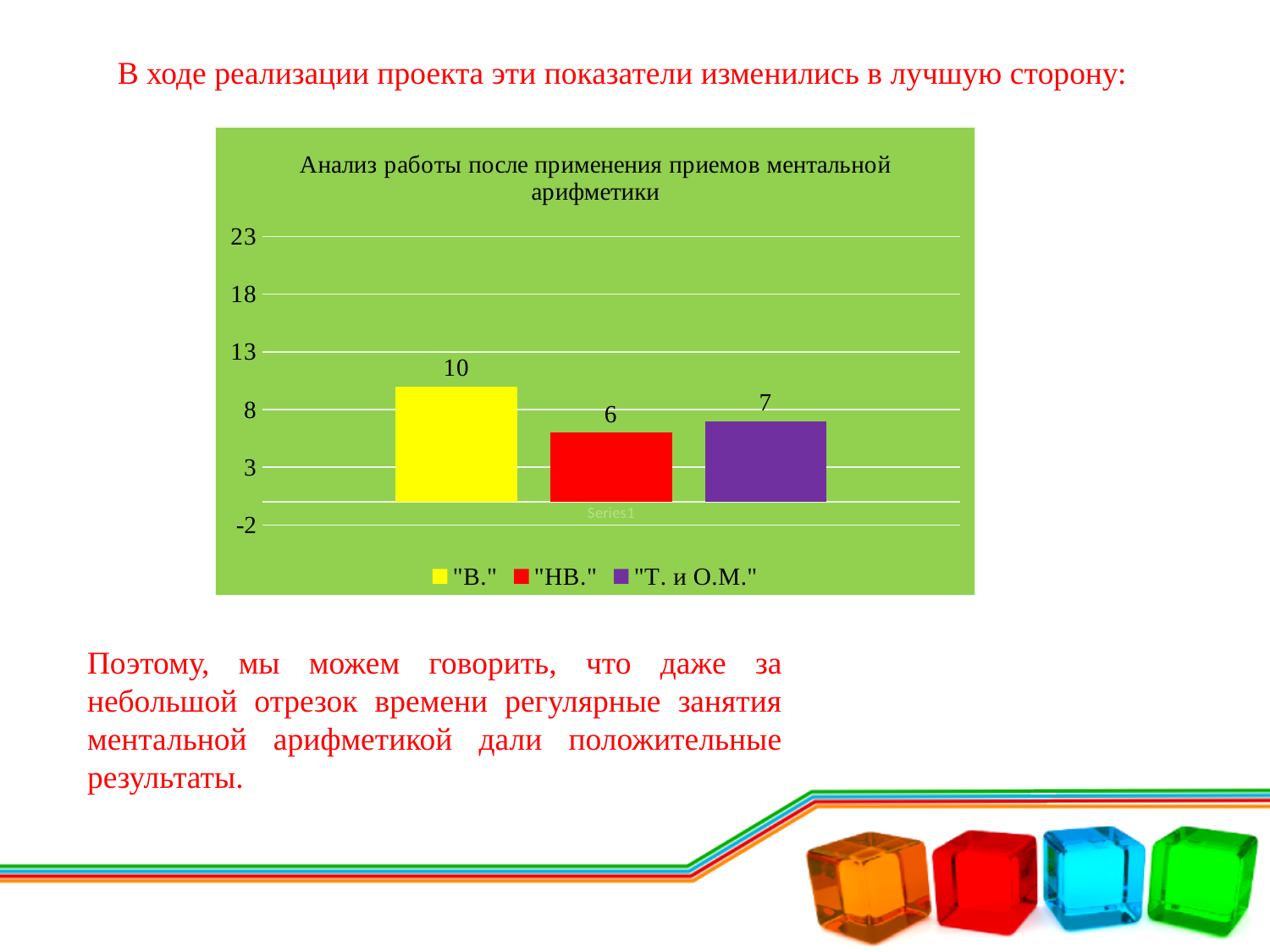
Which legend entry has the highest value in the chart? "В." What is the difference between the values for "Т. и О.М." and "НВ."? 1 Which legend entry has the lowest value in the chart? "НВ." How many bars are plotted in the chart? 3 Is the value for "В." greater or less than 8? greater What kind of chart is shown on the slide? bar chart Which is larger, the value for "В." or the value for "Т. и О.М."? "В." What is the title of the chart? Анализ работы после применения приемов ментальной арифметики What is the value for "В." in the chart? 10 What is the difference between the values for "В." and "НВ."? 4 What is the value for "НВ." in the chart? 6 What is the value for "Т. и О.М." in the chart? 7